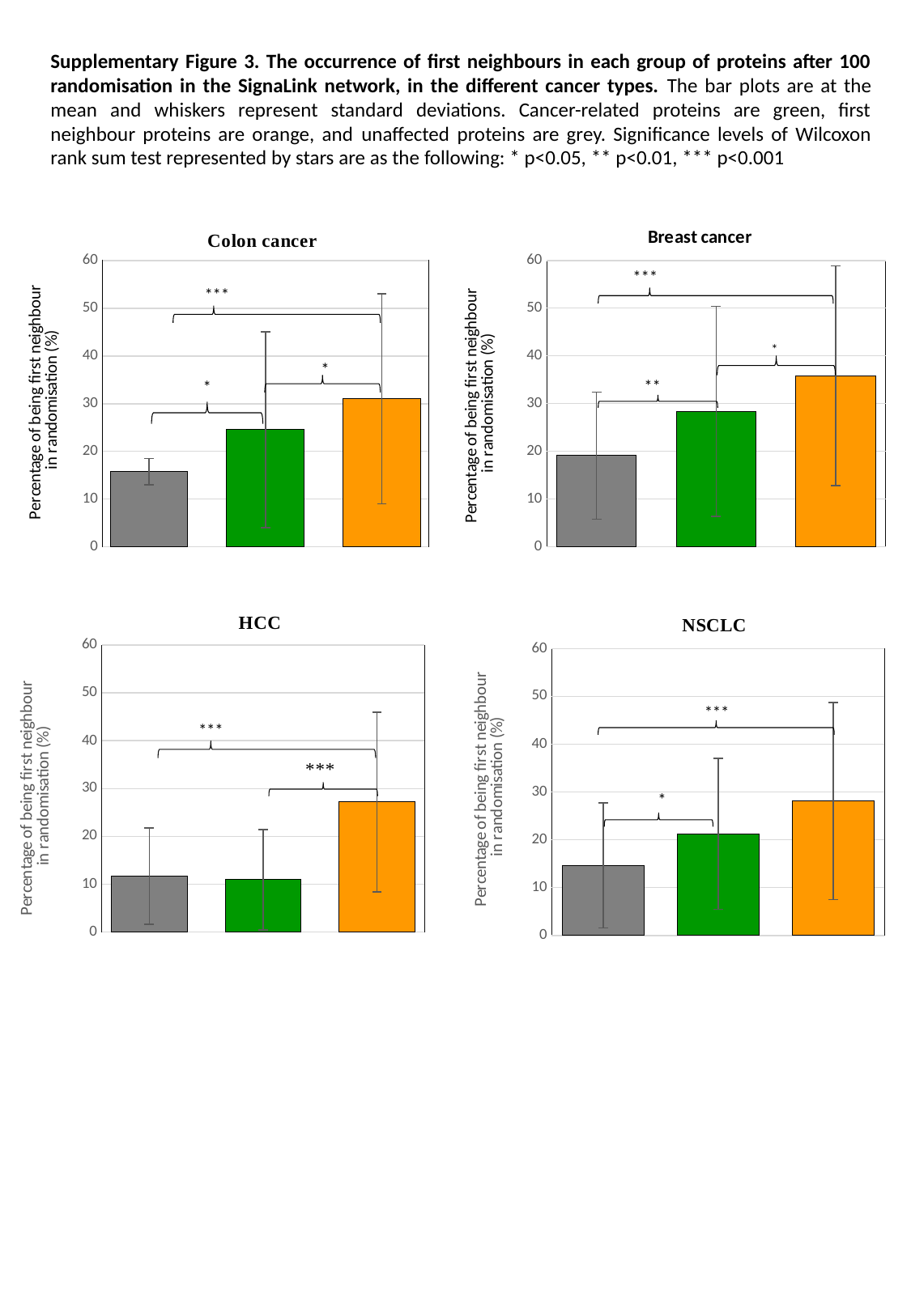
In the Colon cancer chart, which bar is the lowest? the grey bar In the NSCLC chart, which is larger, the grey bar or the green bar? the green bar In the Breast cancer chart, is the orange bar greater or less than 30? greater What is the maximum value shown on the y axis of the Colon cancer chart? 60 How many bars are plotted in the Breast cancer chart? 3 In the Breast cancer chart, is the grey bar greater or less than 20? less In the Colon cancer chart, which bar is the highest? the orange bar In the NSCLC chart, is the orange bar greater or less than 30? less What is the title of the bottom-right chart? NSCLC What kind of chart is the Colon cancer chart? bar chart In the HCC chart, which bar is the highest? the orange bar